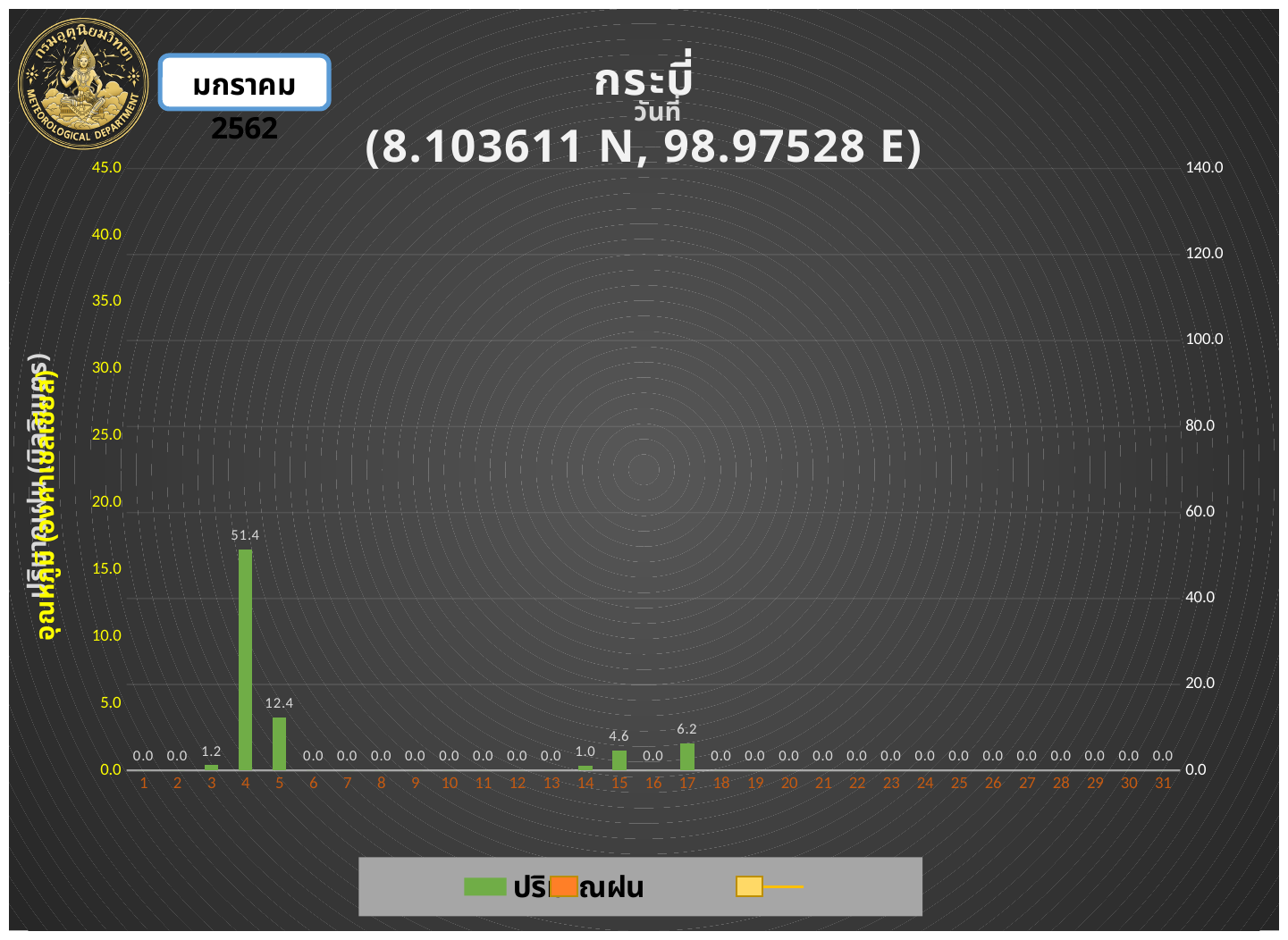
What is the rainfall value shown for day 17? 6.2 What type of chart is shown on the slide? bar chart What is the difference between the rainfall values for day 4 and day 5? 39.0 Which is larger, the rainfall value for day 15 or for day 17? day 17 What is the rainfall value shown for day 3? 1.2 Which day has the highest rainfall value? 4 What is the rainfall value shown for day 4? 51.4 What is the rainfall value shown for day 15? 4.6 What is the rainfall value shown for day 5? 12.4 What are the coordinates shown in the chart title? 8.103611 N, 98.97528 E How many days are shown on the x axis? 31 What is the difference between the rainfall values for day 17 and day 15? 1.6